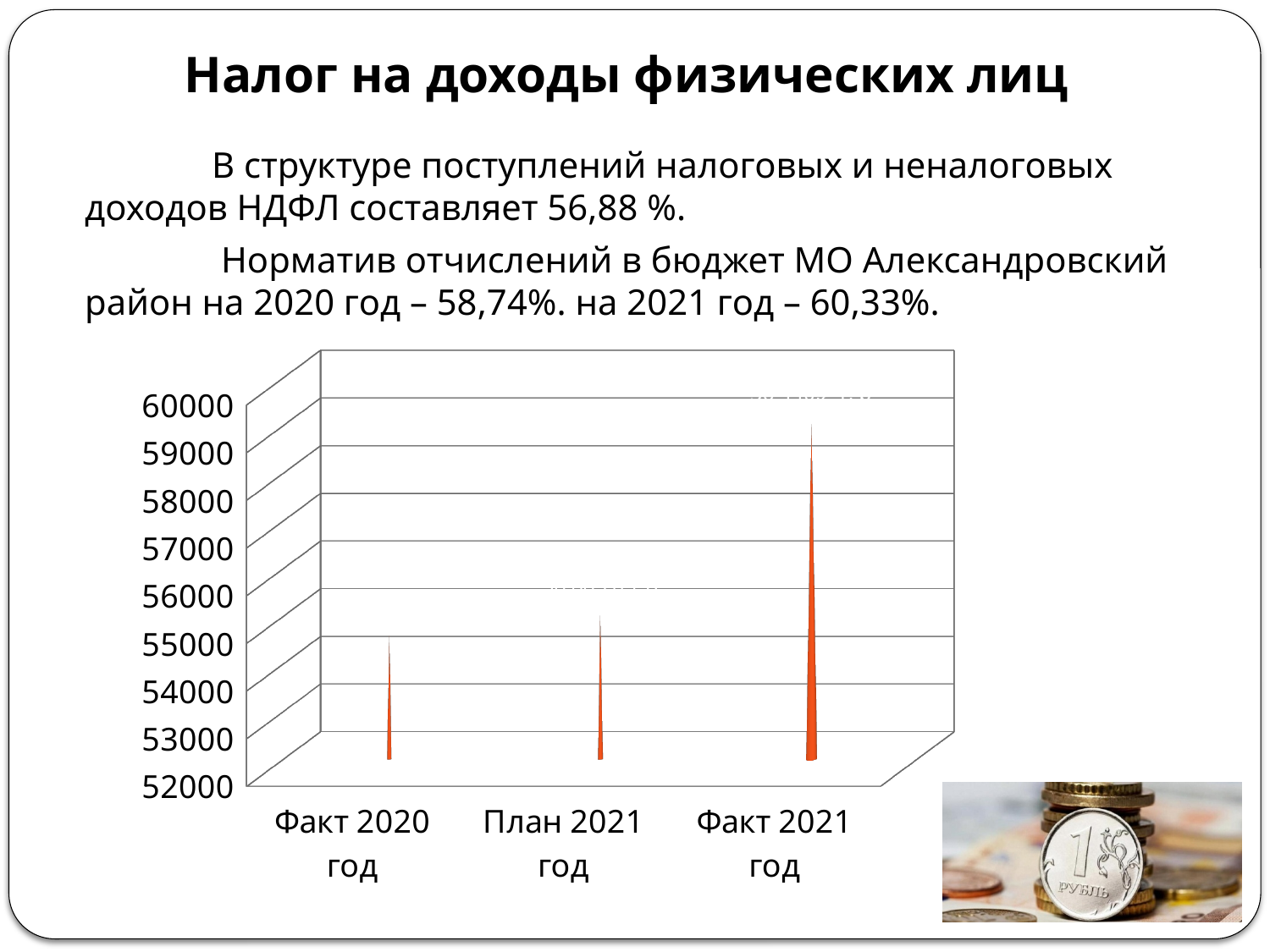
Is the value for Факт 2020 год greater or less than 56000? less Which is larger, the value for Факт 2021 год or the value for План 2021 год? Факт 2021 год How many categories are shown on the x axis of the chart? 3 Is the value for План 2021 год greater or less than 57000? less Is the value for Факт 2021 год greater or less than 58000? greater Which category has the highest value in the chart? Факт 2021 год Do the values rise or fall from Факт 2020 год to Факт 2021 год? rise What is the lowest value shown on the vertical axis of the chart? 52000 What kind of chart is shown on the slide? bar chart What colour are the bars in the chart? orange